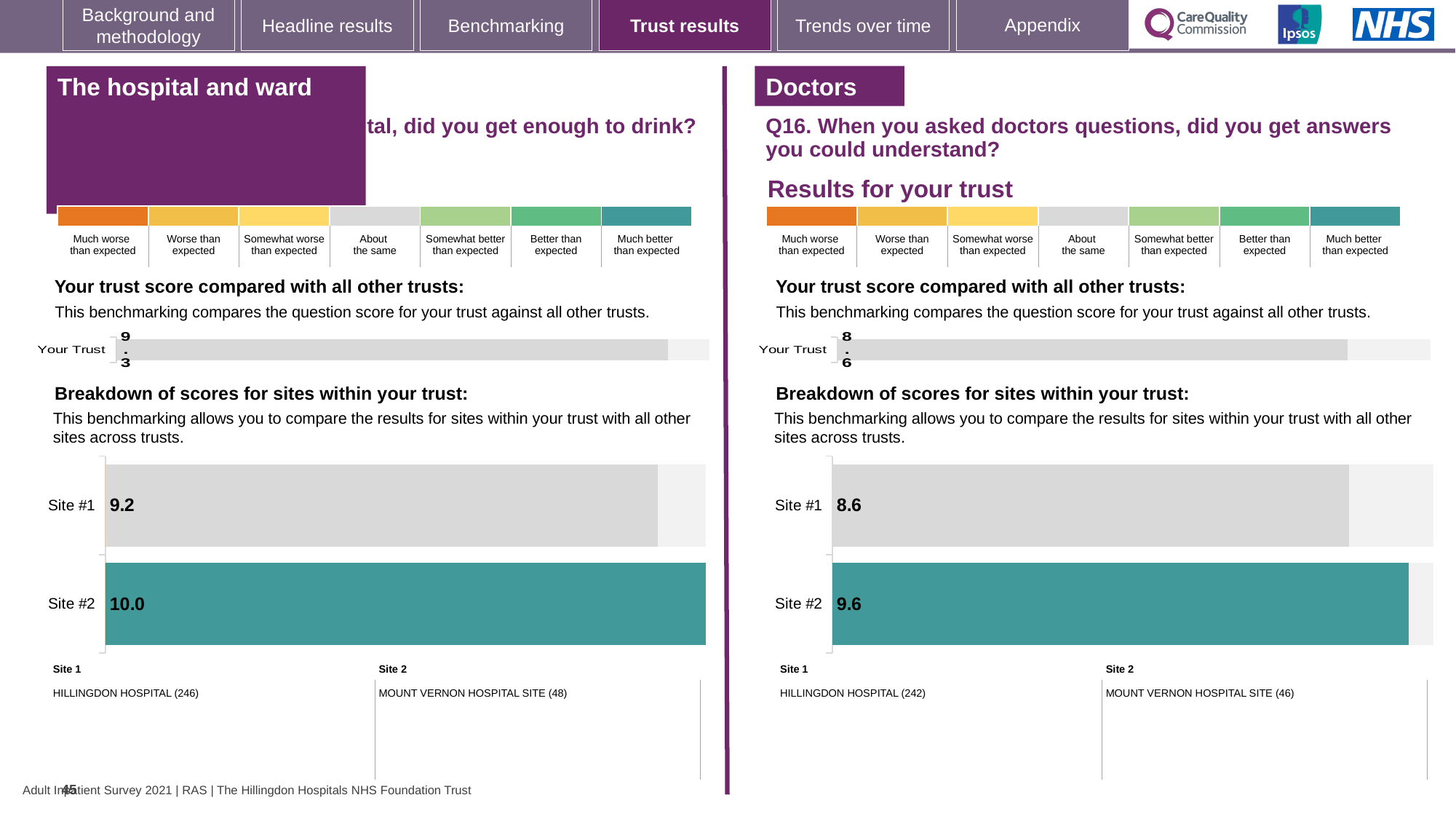
In the left-hand 'Your trust score compared with all other trusts' chart, what is the score shown for Your Trust? 9.3 In the Q16 (Doctors) 'Breakdown of scores for sites within your trust' chart, what is the score for Site #2? 9.6 What type of chart is used for the site breakdown on the left-hand side of the slide? Bar chart In the left-hand 'Breakdown of scores for sites within your trust' chart, what is the score for Site #2? 10.0 In the left-hand site breakdown chart, which site has the higher score? Site #2 In the Q16 (Doctors) 'Breakdown of scores for sites within your trust' chart, what is the score for Site #1? 8.6 In the left-hand site breakdown chart, what is the difference between the Site #2 and Site #1 scores? 0.8 In the Q16 (Doctors) site breakdown chart, which site has the lower score? Site #1 In the Q16 (Doctors) 'Your trust score compared with all other trusts' chart, what is the score shown for Your Trust? 8.6 How many sites are shown in the Q16 (Doctors) site breakdown chart? 2 In the Q16 (Doctors) site breakdown chart, what is the difference between the Site #2 and Site #1 scores? 1.0 In the left-hand 'Breakdown of scores for sites within your trust' chart, what is the score for Site #1? 9.2